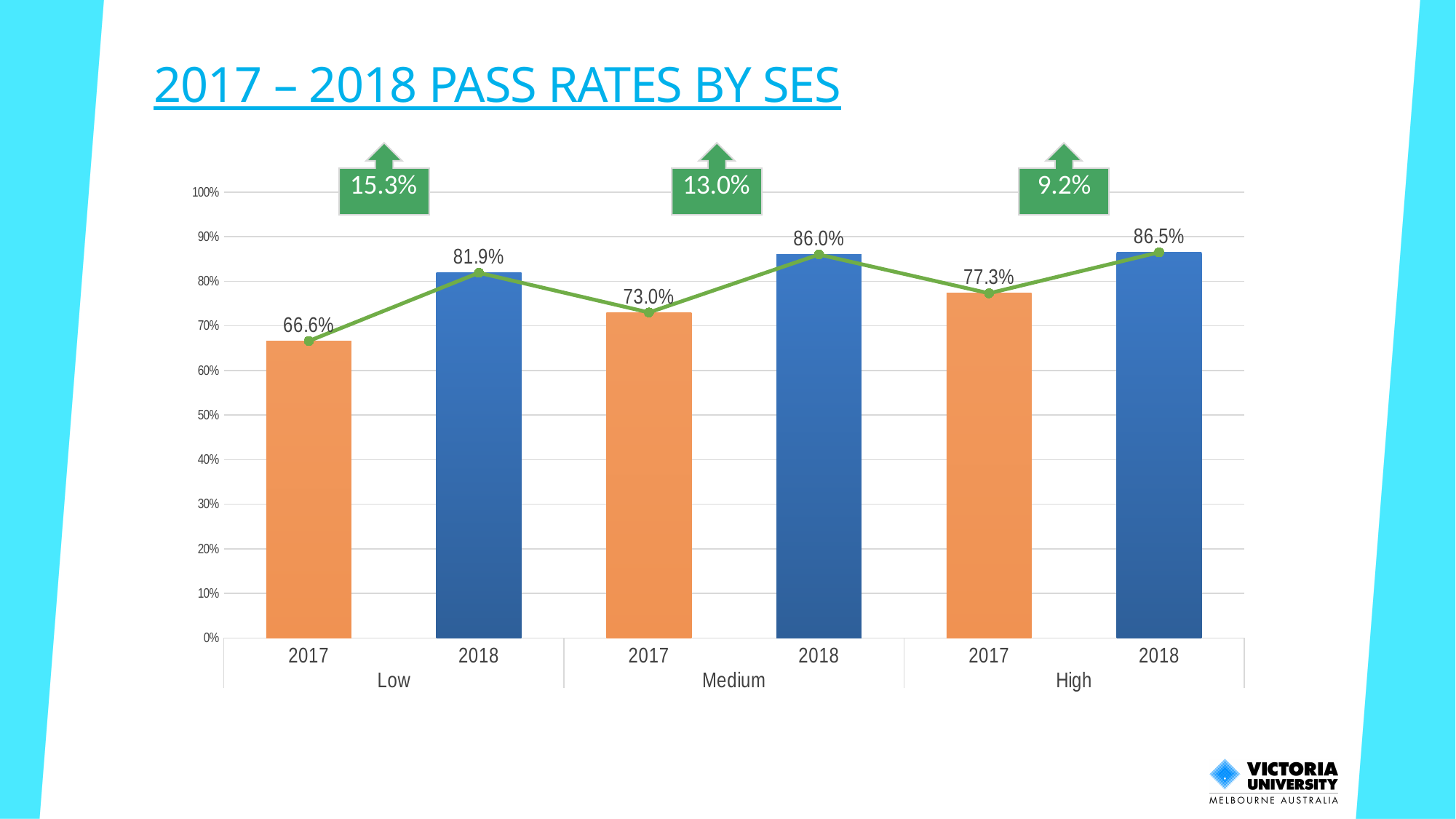
Which bar has the lowest pass rate? Low, 2017 (66.6%) What is the pass rate for the Low SES group in 2017? 66.6% Which bar has the highest pass rate? High, 2018 (86.5%) What is the title of the slide? 2017 – 2018 PASS RATES BY SES What is the pass rate for the High SES group in 2017? 77.3% Is the 2018 pass rate for the Low SES group greater or less than 80%? greater What is the pass rate for the Medium SES group in 2018? 86.0% How many bars are plotted in the chart? 6 By how many percentage points did the pass rate for the Low SES group increase from 2017 to 2018? 15.3% What is the difference between the 2018 pass rates of the High and Medium SES groups? 0.5% Which is larger: the 2017 pass rate for Medium SES or the 2017 pass rate for High SES? High SES (77.3%) What kind of chart is shown on the slide? Bar chart with a line overlay